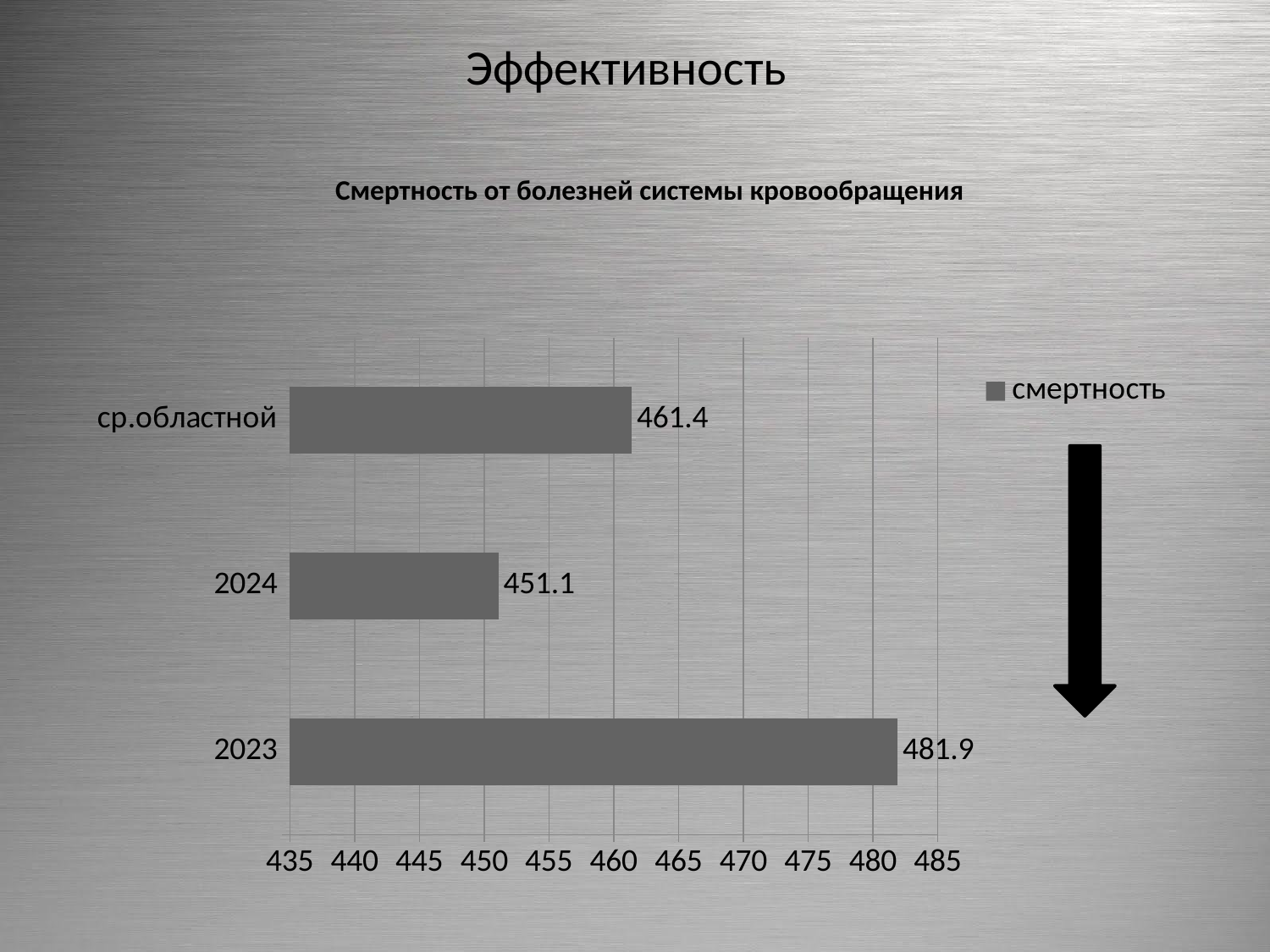
How many categories are shown in the chart? 3 What is the difference between the values for 2023 and 2024? 30.8 Which is larger, the value for 2024 or the value for ср.областной? ср.областной Is the value for 2023 greater or less than 480? greater Which category has the lowest value? 2024 Which category has the highest value? 2023 What is the value for ср.областной? 461.4 What is the value for 2023? 481.9 What is the title of the chart? Смертность от болезней системы кровообращения What is the difference between the values for ср.областной and 2024? 10.3 What is the value for 2024? 451.1 What kind of chart is shown on the slide? bar chart